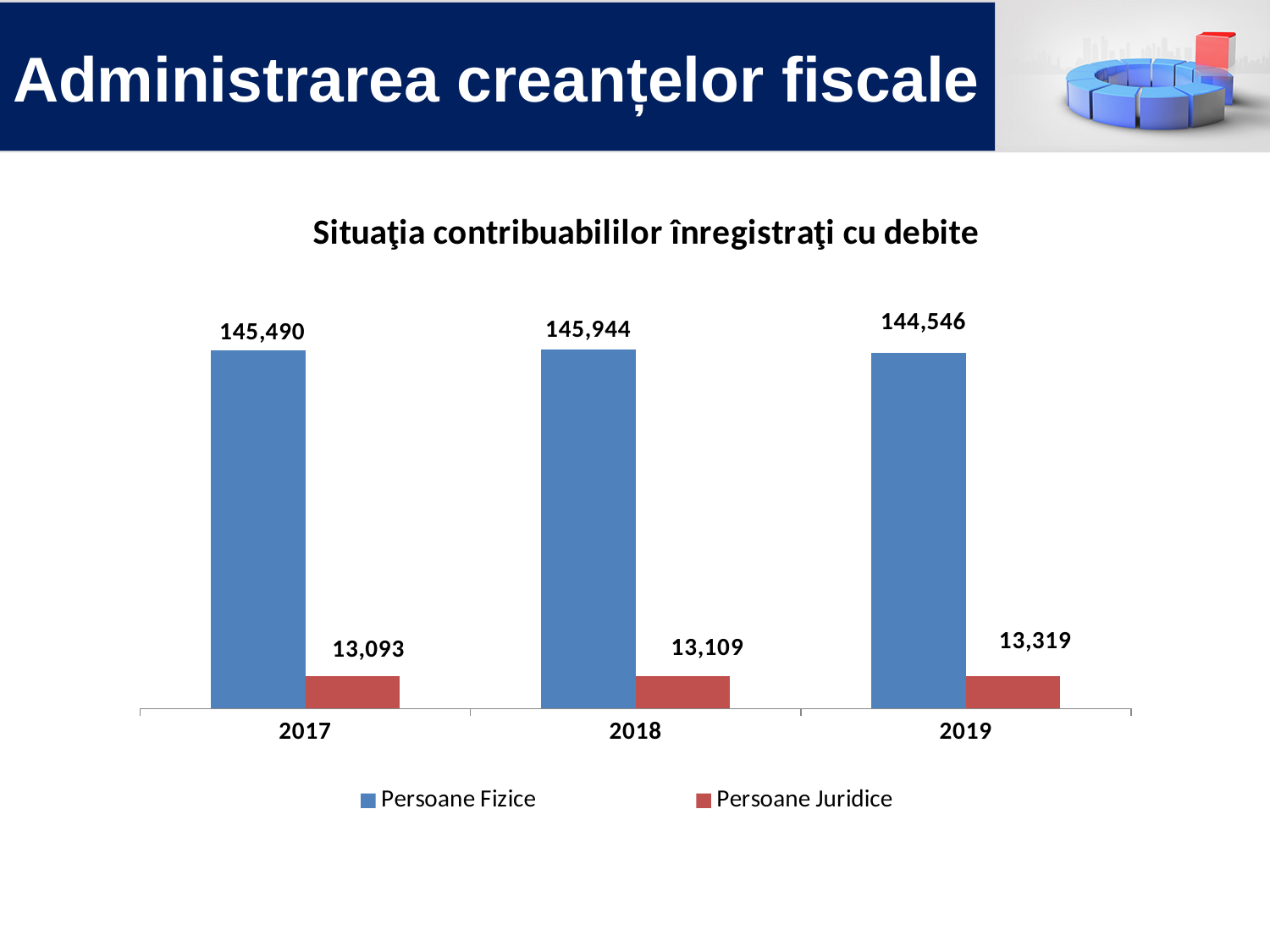
What is the value for Persoane Juridice in 2017? 13,093 What is the value for Persoane Fizice in 2018? 145,944 What is the value for Persoane Juridice in 2019? 13,319 What is the value for Persoane Fizice in 2017? 145,490 How many years are shown on the x axis? 3 What kind of chart is shown on the slide? Bar chart What is the difference between Persoane Fizice and Persoane Juridice in 2019? 131,227 How many series does the legend list? 2 What is the title of the chart? Situaţia contribuabililor înregistraţi cu debite Which is larger in 2018: Persoane Fizice or Persoane Juridice? Persoane Fizice In which year is the Persoane Fizice value highest? 2018 In which year is the Persoane Juridice value lowest? 2017